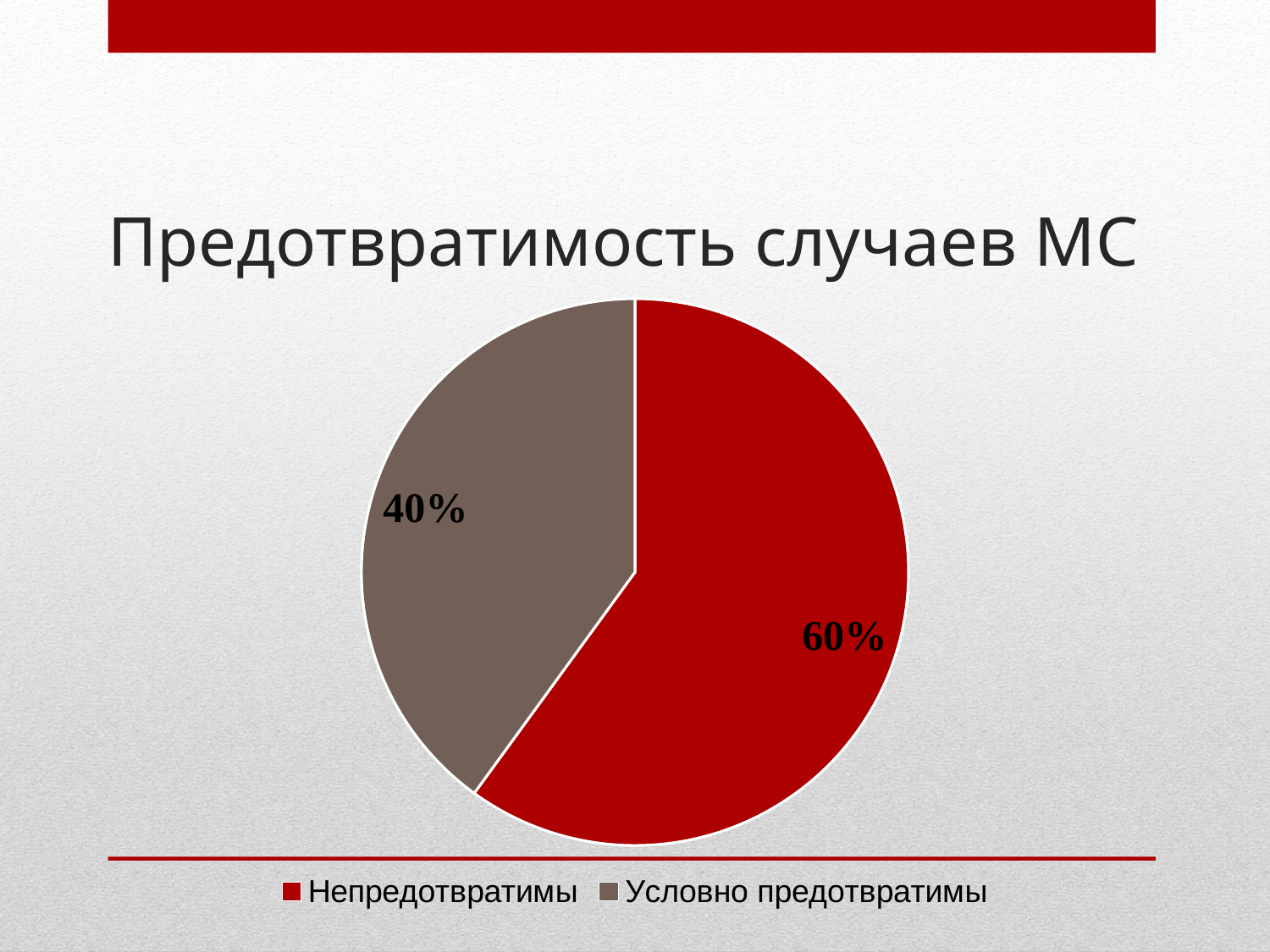
What is the difference between the Непредотвратимы and Условно предотвратимы shares? 20% What share of the pie is labelled Условно предотвратимы? 40% Which slice is the largest? Непредотвратимы What is the title of the slide? Предотвратимость случаев МС Which is larger, Непредотвратимы or Условно предотвратимы? Непредотвратимы What kind of chart is shown on the slide? pie chart How many entries does the legend list? 2 What share of the pie is labelled Непредотвратимы? 60% Which slice is the smallest? Условно предотвратимы What colour is the Условно предотвратимы slice? grey-brown How many slices does the pie chart have? 2